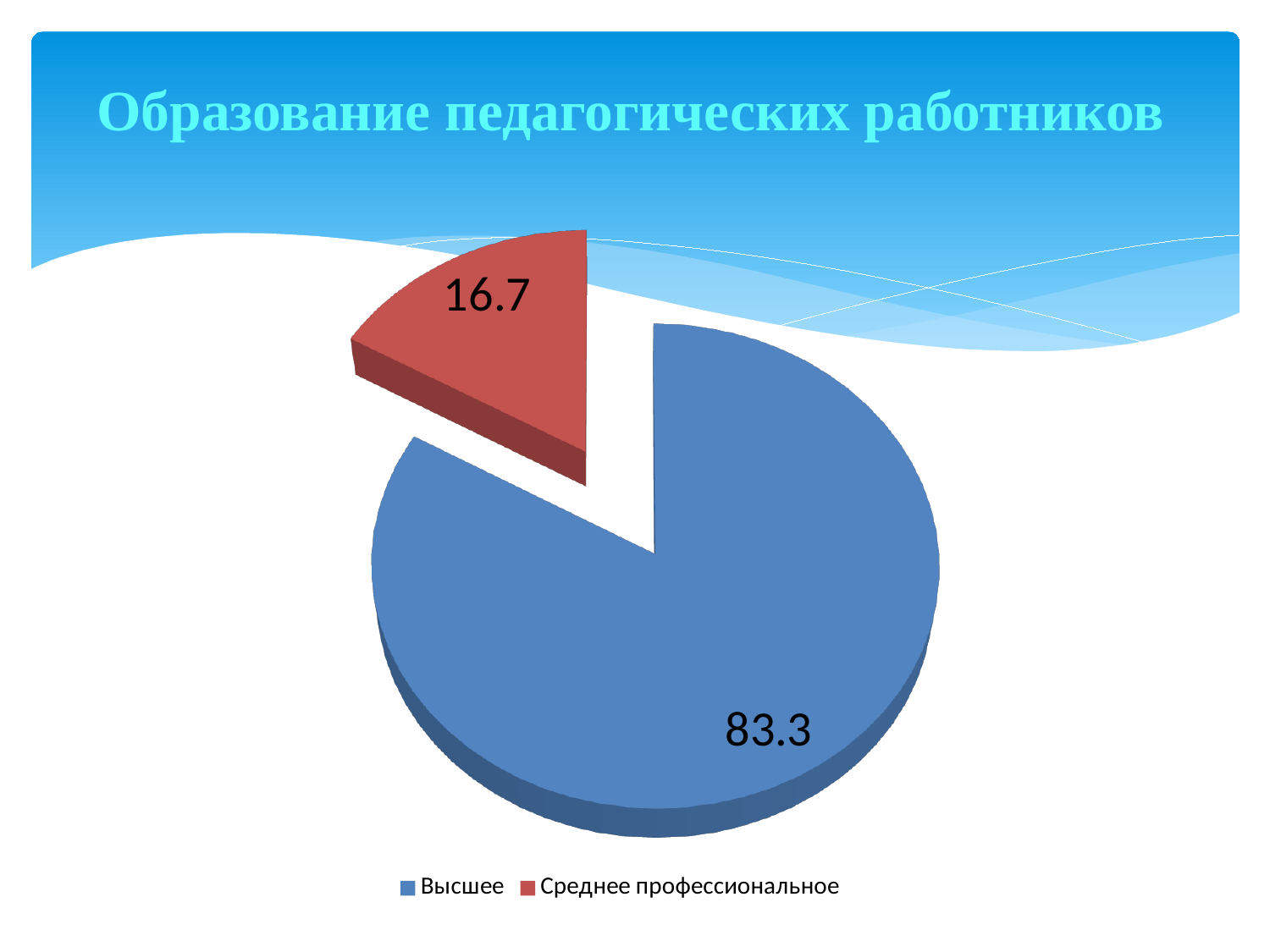
Which is larger, the value for Высшее or the value for Среднее профессиональное? Высшее Which category has the largest slice? Высшее What kind of chart is shown on the slide? pie chart How many slices does the pie chart have? 2 Which category has the smallest slice? Среднее профессиональное What is the value for Высшее? 83.3 What is the total of the two slice values? 100 What colour is the slice for Среднее профессиональное? red What is the difference between the values for Высшее and Среднее профессиональное? 66.6 How many entries does the legend list? 2 What is the value for Среднее профессиональное? 16.7 What is the title of the chart? Образование педагогических работников